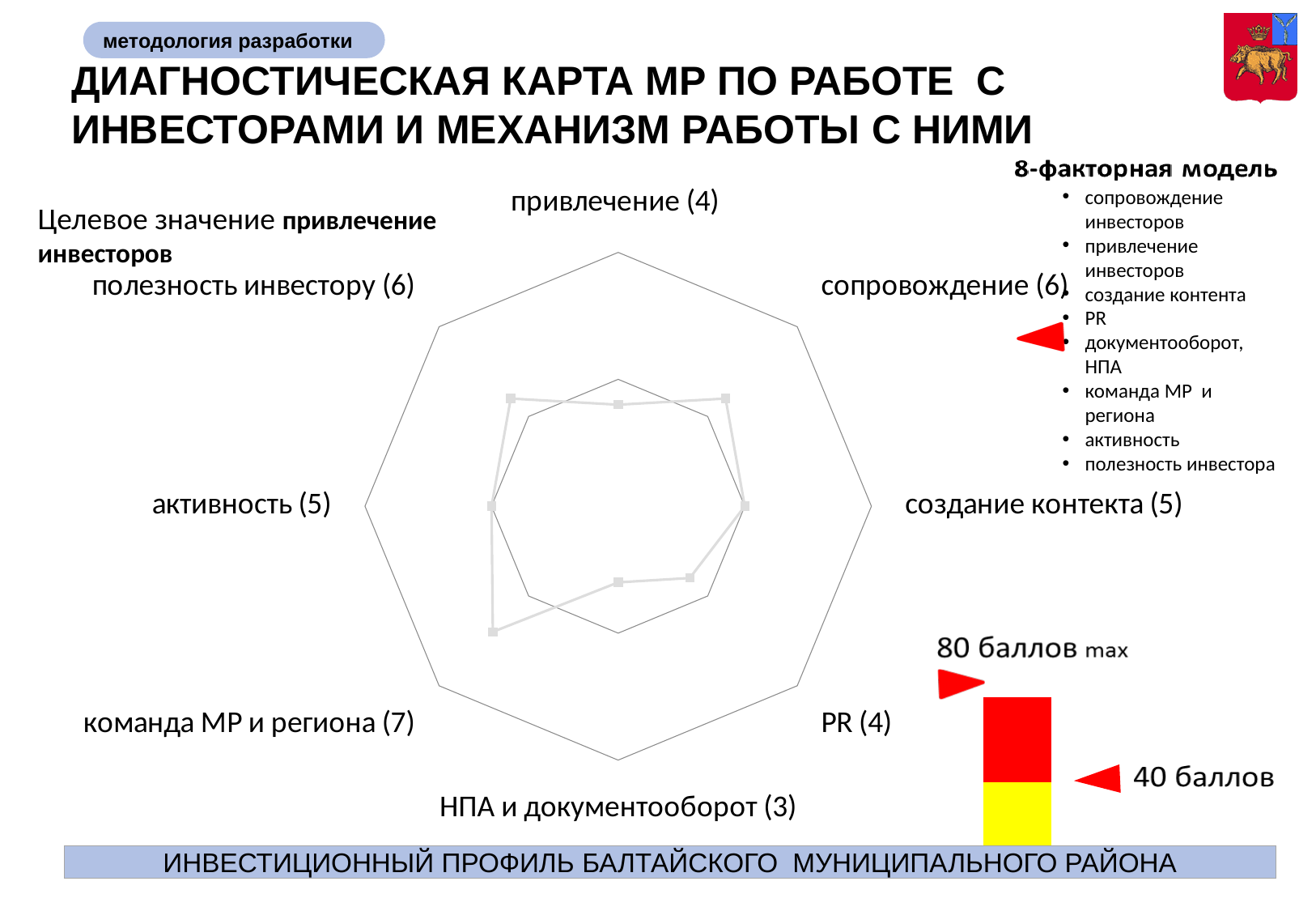
What is the difference between the values for 'команда МР и региона' and 'НПА и документооборот'? 4 What value is shown for 'команда МР и региона' on the radar chart? 7 Which has a larger value, 'полезность инвестору' or 'привлечение'? полезность инвестору What is the name of the model described next to the radar chart? 8-факторная модель How many categories (axes) does the radar chart have? 8 What kind of chart is shown on the slide? radar chart Which category has the highest value on the radar chart? команда МР и региона What value is shown for 'активность' on the radar chart? 5 What value is shown for 'НПА и документооборот' on the radar chart? 3 What value is shown for 'сопровождение' on the radar chart? 6 Which category has the lowest value on the radar chart? НПА и документооборот What value is shown for 'PR' on the radar chart? 4